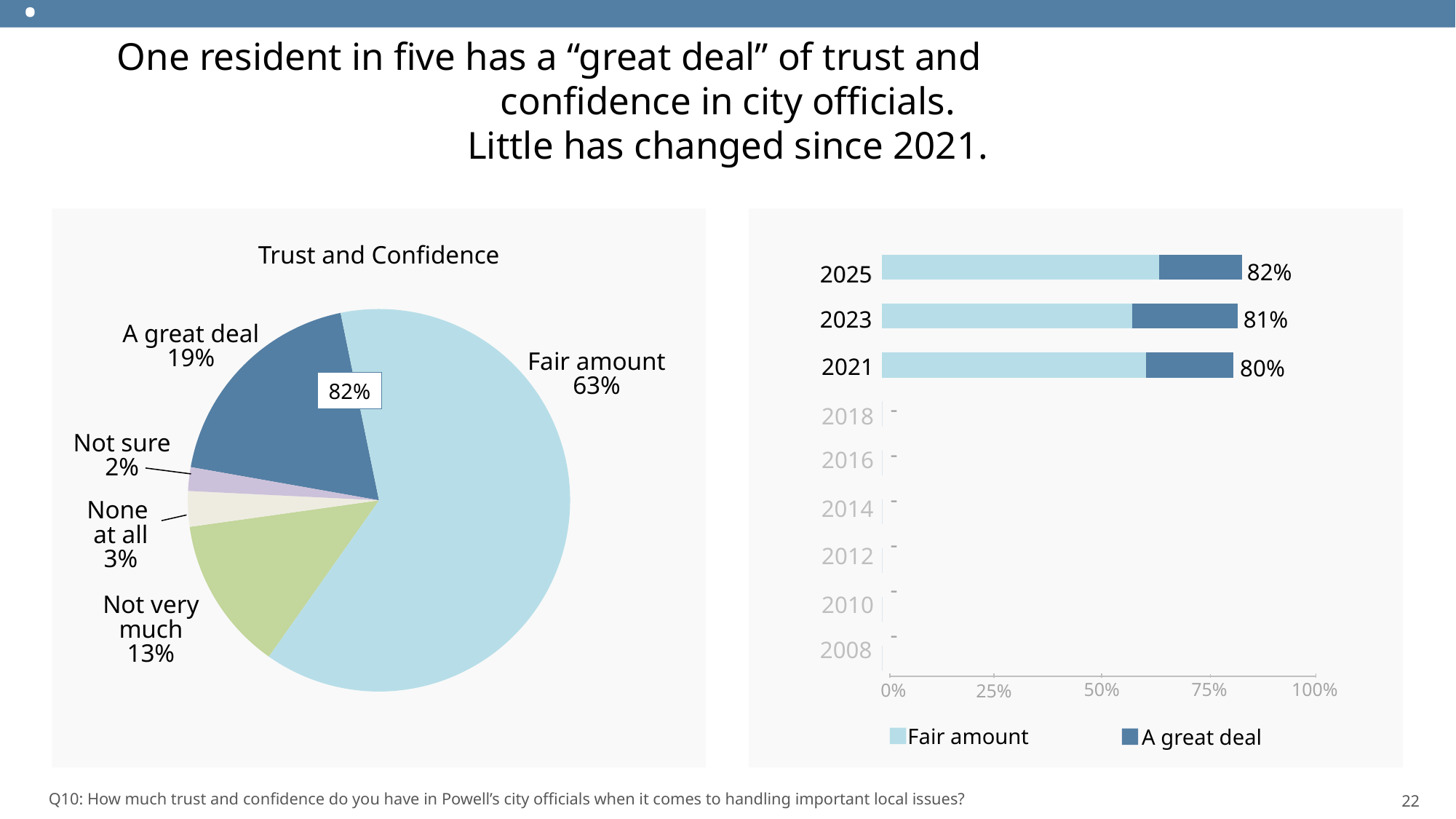
In the bar chart on the right, is the Fair amount segment for 2023 greater or less than 50%? greater In the Trust and Confidence pie chart, which category has the smallest slice? Not sure In the Trust and Confidence pie chart, what is the difference between the A great deal and Not very much percentages? 6% How many series does the legend of the bar chart on the right list? 2 In the bar chart on the right, do the labelled totals rise or fall from 2021 to 2025? Rise In the bar chart on the right, what total percentage is labelled for 2025? 82% What kind of chart is the chart on the right of the slide? Bar chart What kind of chart is the Trust and Confidence chart on the left? Pie chart In the Trust and Confidence pie chart, which category has the largest slice? Fair amount How many slices does the Trust and Confidence pie chart have? 5 In the Trust and Confidence pie chart, which is larger: Not very much or None at all? Not very much In the Trust and Confidence pie chart, what percentage is shown for Fair amount? 63%